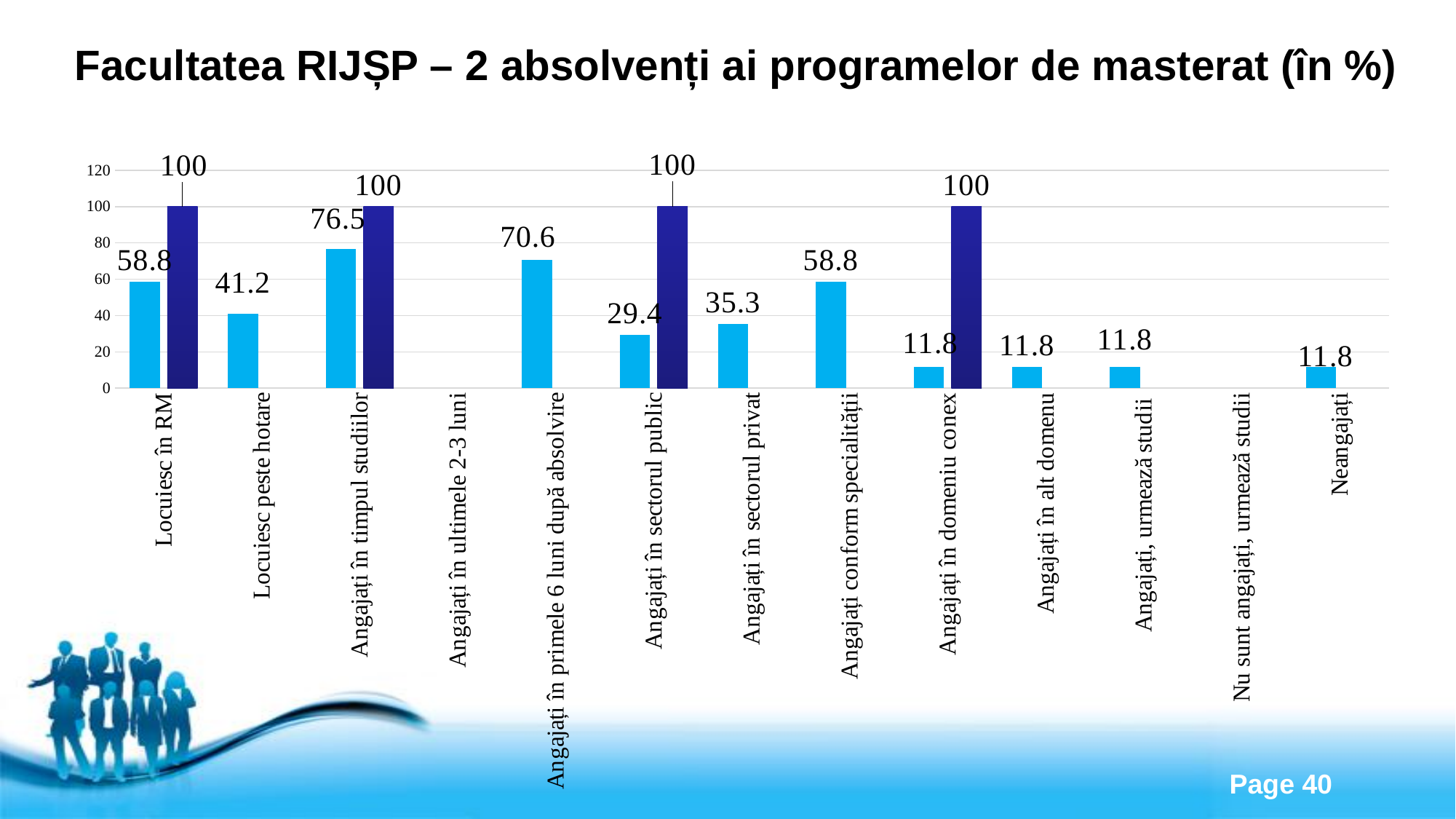
What type of chart is shown on the slide? bar chart What is the light blue value for "Angajați în timpul studiilor"? 76.5 What is the light blue value for "Locuiesc în RM"? 58.8 What is the dark blue value for "Angajați în domeniu conex"? 100 What is the difference between the light blue values for "Angajați în timpul studiilor" and "Locuiesc în RM"? 17.7 What is the value for "Angajați în sectorul privat"? 35.3 Which is larger, the light blue value for "Angajați în sectorul privat" or for "Angajați în sectorul public"? Angajați în sectorul privat What is the light blue value for "Angajați în sectorul public"? 29.4 What is the light blue value for "Locuiesc peste hotare"? 41.2 What is the value for "Angajați în primele 6 luni după absolvire"? 70.6 How many categories are shown on the x axis? 13 What is the value for "Neangajați"? 11.8